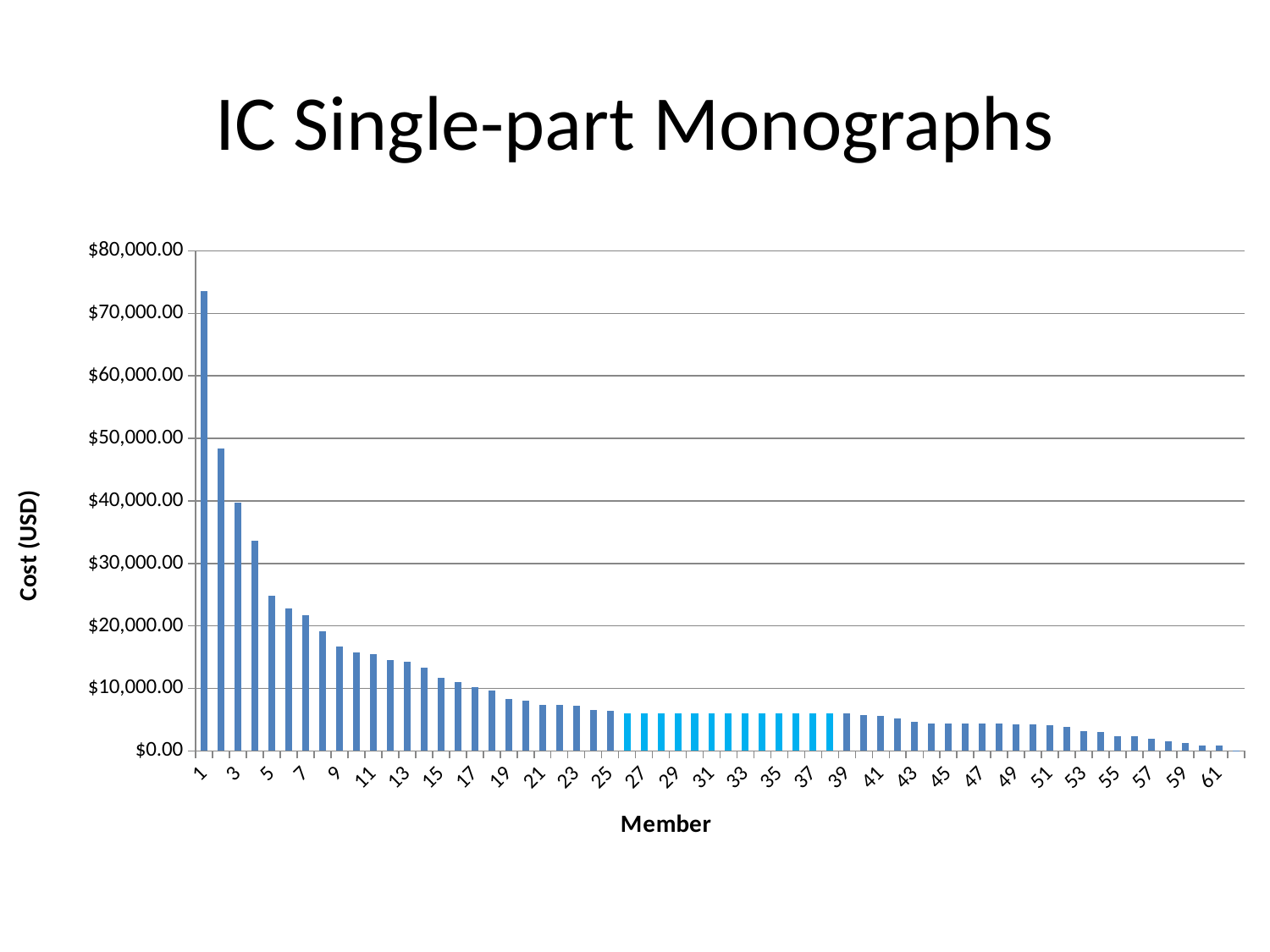
Which has the higher cost, Member 1 or Member 2? Member 1 Do the costs rise or fall as the member number increases along the x axis? fall What kind of chart is shown on the slide? bar chart Which has the higher cost, Member 5 or Member 15? Member 5 Is the cost for Member 41 greater or less than $10,000.00? less Which member has the highest cost? 1 Is the cost for Member 2 greater or less than $50,000.00? less Is the cost for Member 4 greater or less than $30,000.00? greater What is the title of the vertical axis? Cost (USD)